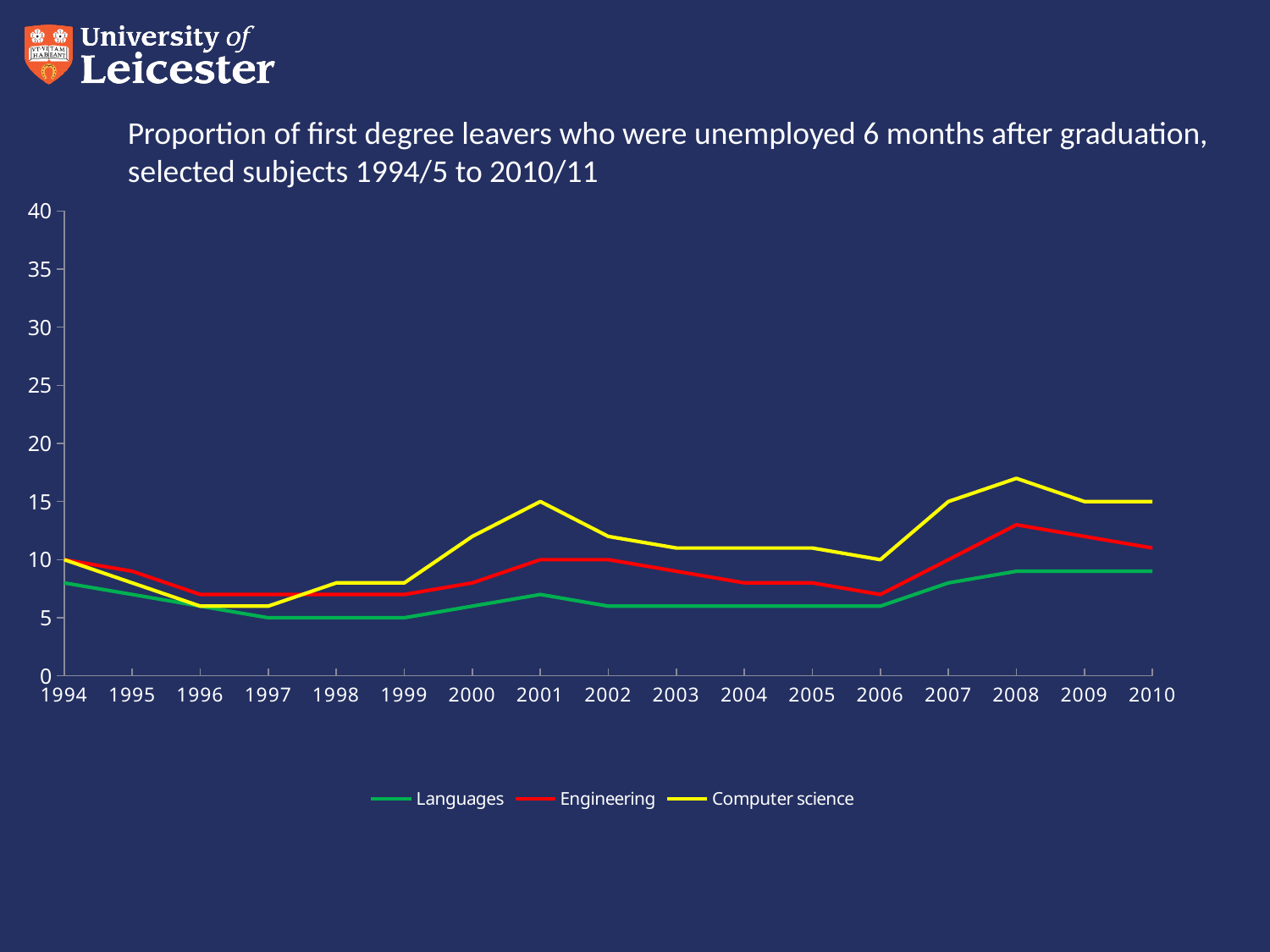
How many years are plotted along the x axis? 17 Which series has the lowest value in 2010? Languages In which year does the Computer science line reach its highest value? 2008 How many series does the legend list? 3 In 2008, which is larger: Computer science or Languages? Computer science Is the value for Languages in 2001 greater or less than 10? less Does the Computer science line rise or fall between 2006 and 2008? rise What is the value for Languages in 1997? 5 What colour is the Computer science line? yellow What kind of chart is shown on the slide? line chart What is the value for Computer science in 2001? 15 Is the value for Computer science in 2008 greater or less than 15? greater